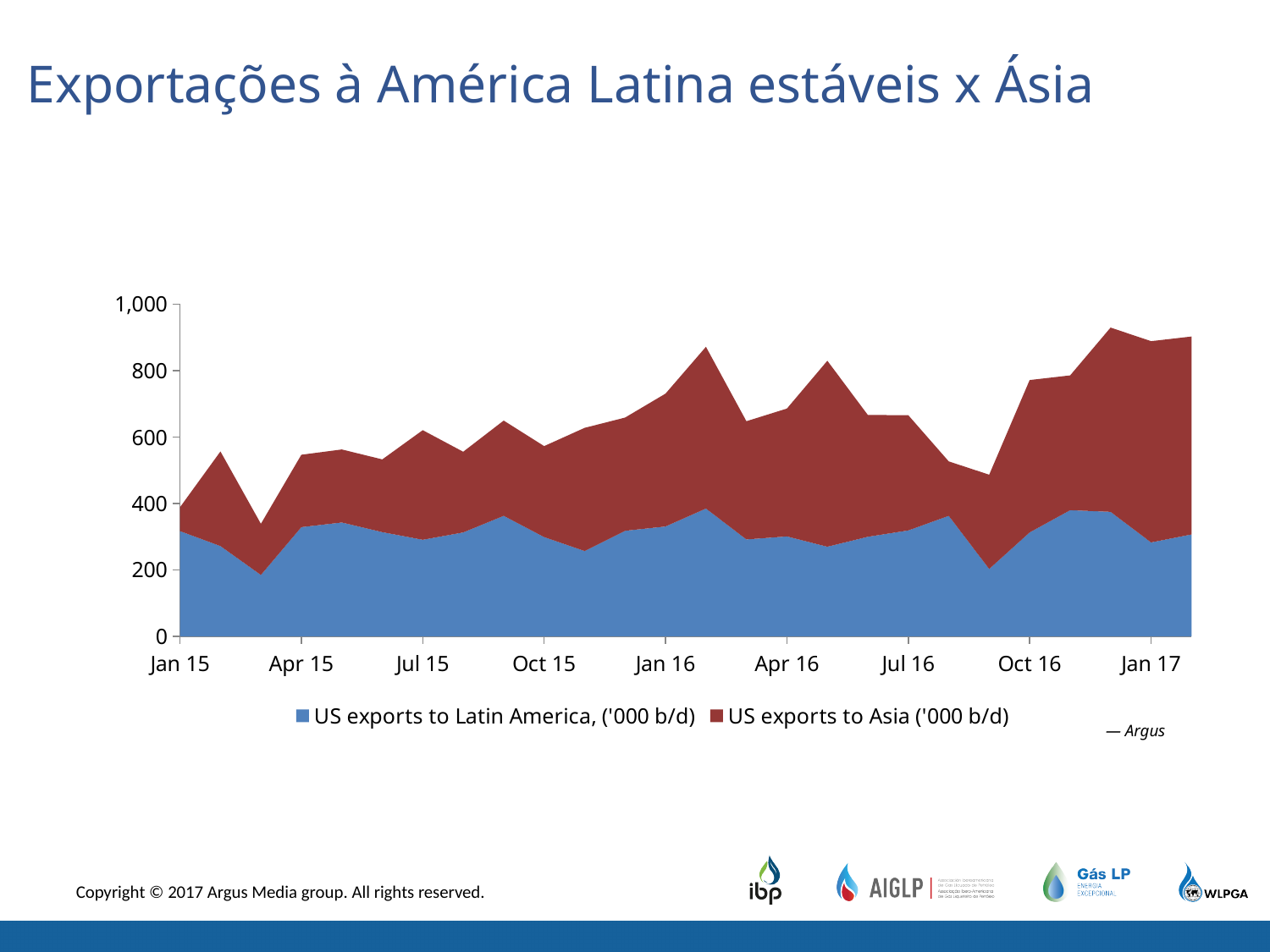
Is the value for US exports to Latin America at Jan 15 greater or less than 200? greater What are the two series named in the legend? US exports to Latin America, ('000 b/d) and US exports to Asia ('000 b/d) Which colour represents US exports to Asia? Red Which series shows the larger increase between Jan 15 and Jan 17, US exports to Latin America or US exports to Asia? US exports to Asia How many labelled tick marks are on the x axis? 9 Is the value for US exports to Latin America at Jan 17 greater or less than 400? less Is the combined total of both series at Oct 16 greater or less than 600? greater What kind of chart is shown on the slide? Stacked area chart Does the combined total of US exports rise or fall overall from Jan 15 to Jan 17? Rise How many series does the legend list? 2